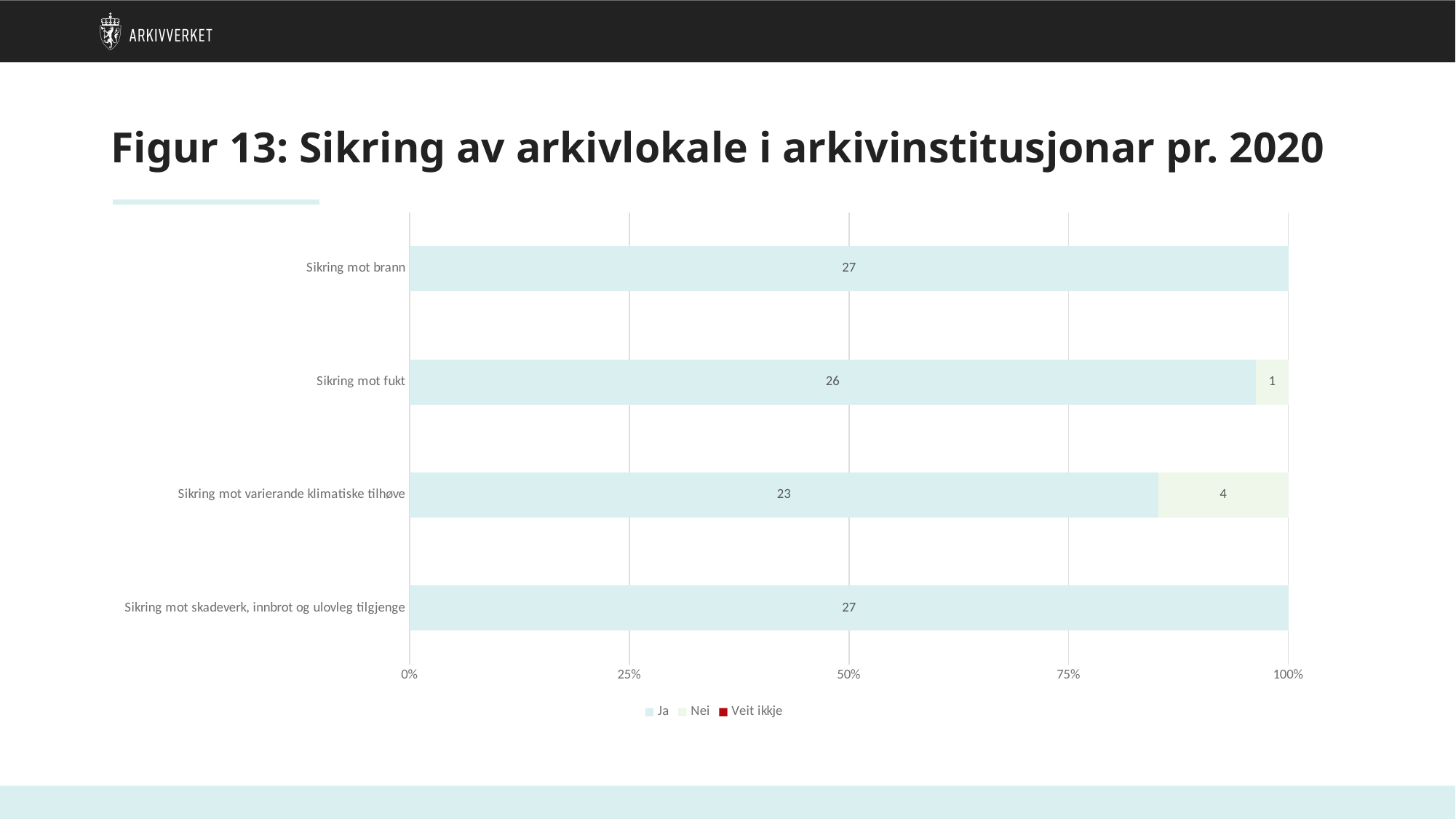
What is the "Ja" value for "Sikring mot fukt"? 26 What is the "Ja" value for "Sikring mot brann"? 27 What is the "Nei" value for "Sikring mot varierande klimatiske tilhøve"? 4 How many series does the legend list? 3 What is the difference between the "Ja" values for "Sikring mot brann" and "Sikring mot varierande klimatiske tilhøve"? 4 What kind of chart is shown on the slide? Stacked bar chart What is the total of the stacked bar for "Sikring mot varierande klimatiske tilhøve"? 27 What is the "Nei" value for "Sikring mot fukt"? 1 Which category has the highest "Nei" value? Sikring mot varierande klimatiske tilhøve How many categories are shown on the chart? 4 Which category has the lowest "Ja" value? Sikring mot varierande klimatiske tilhøve Which is larger: the "Ja" value for "Sikring mot fukt" or the "Ja" value for "Sikring mot varierande klimatiske tilhøve"? Sikring mot fukt